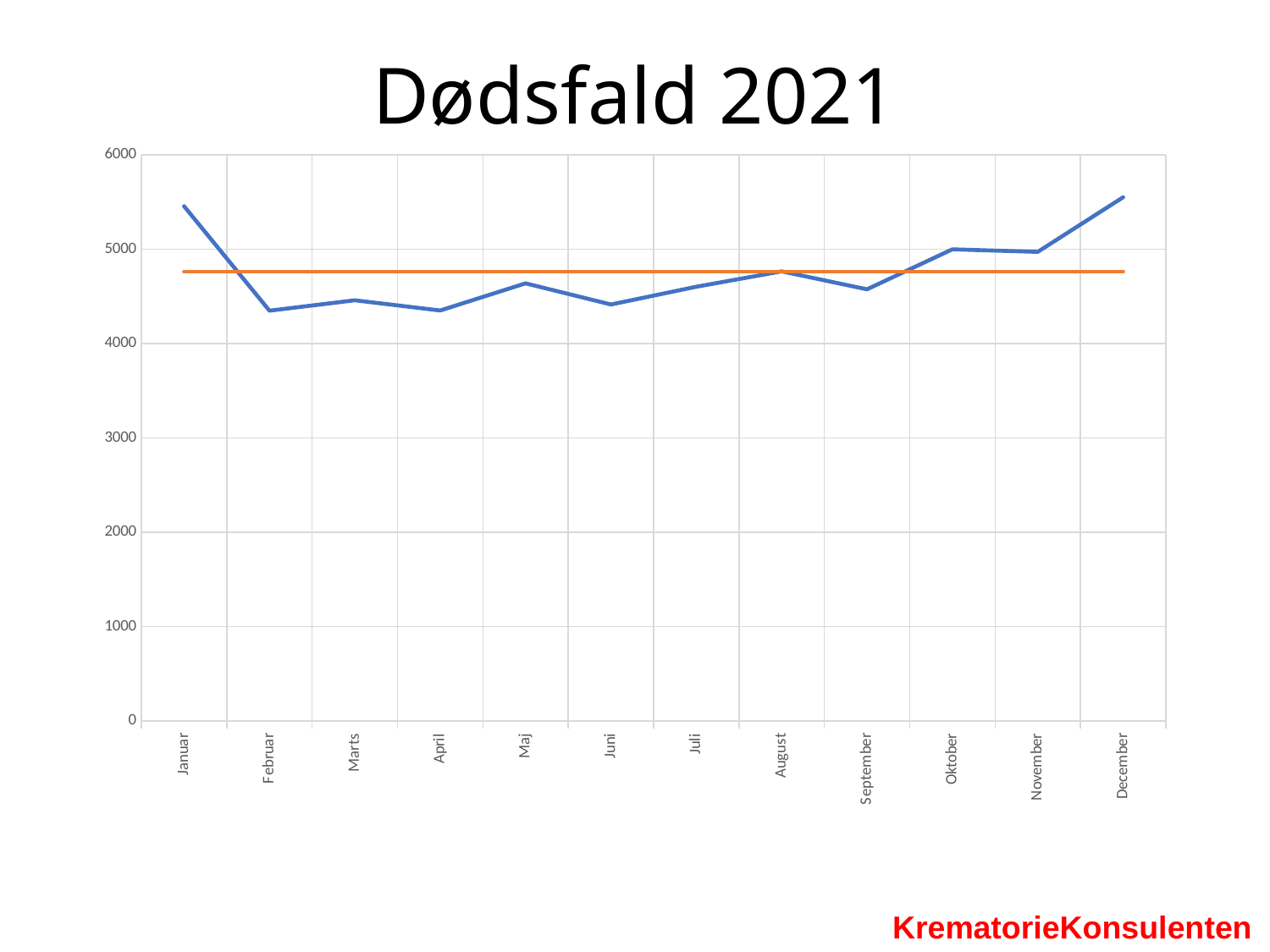
Does the blue line rise or fall from September to December? Rises Is the value of the blue line for Marts greater or less than 4000? greater Is the value of the blue line for Februar greater or less than 5000? less Is the orange line flat or does it change across the months? Flat What kind of chart is shown on the slide? Line chart Which month has a higher value on the blue line, Oktober or September? Oktober Is the value of the blue line for Juni greater or less than 5000? less What is the title of the chart? Dødsfald 2021 Which month has a higher value on the blue line, Januar or Februar? Januar How many months are shown on the x axis of the chart? 12